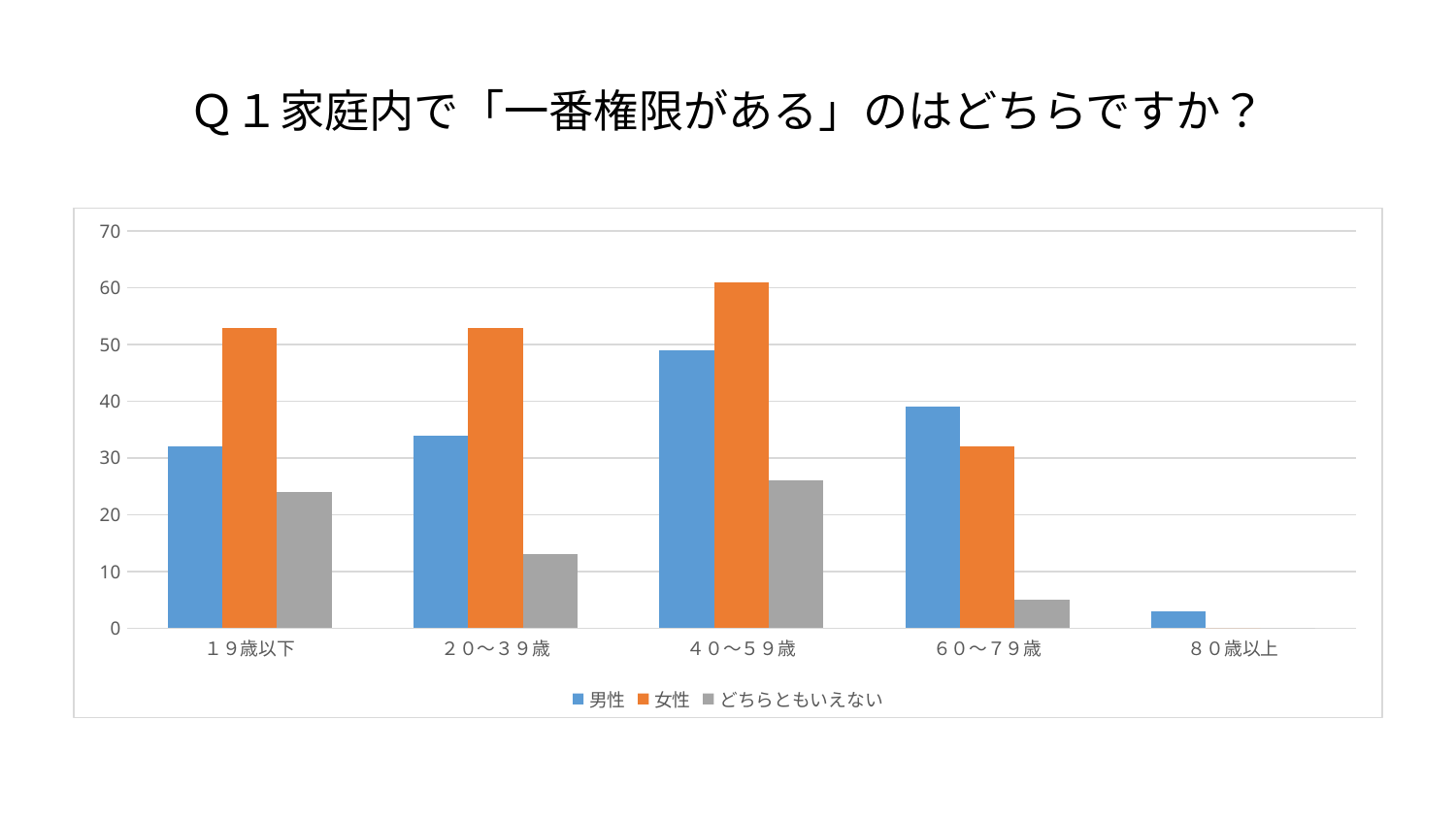
For which age category is the 男性 value lowest? ８０歳以上 For which age category is the 男性 value highest? ４０〜５９歳 What colour represents the 女性 series in the chart? orange What kind of chart is shown on the slide? bar chart Is the 男性 value for ８０歳以上 greater or less than 10? less Is the 女性 value for ４０〜５９歳 greater or less than 50? greater Is the どちらともいえない value for ６０〜７９歳 greater or less than 10? less In the ４０〜５９歳 category, which is larger, 男性 or 女性? 女性 How many age categories are shown on the x axis? 5 In the ６０〜７９歳 category, which is larger, 男性 or 女性? 男性 For which age category is the 女性 value highest? ４０〜５９歳 How many series does the legend list? 3